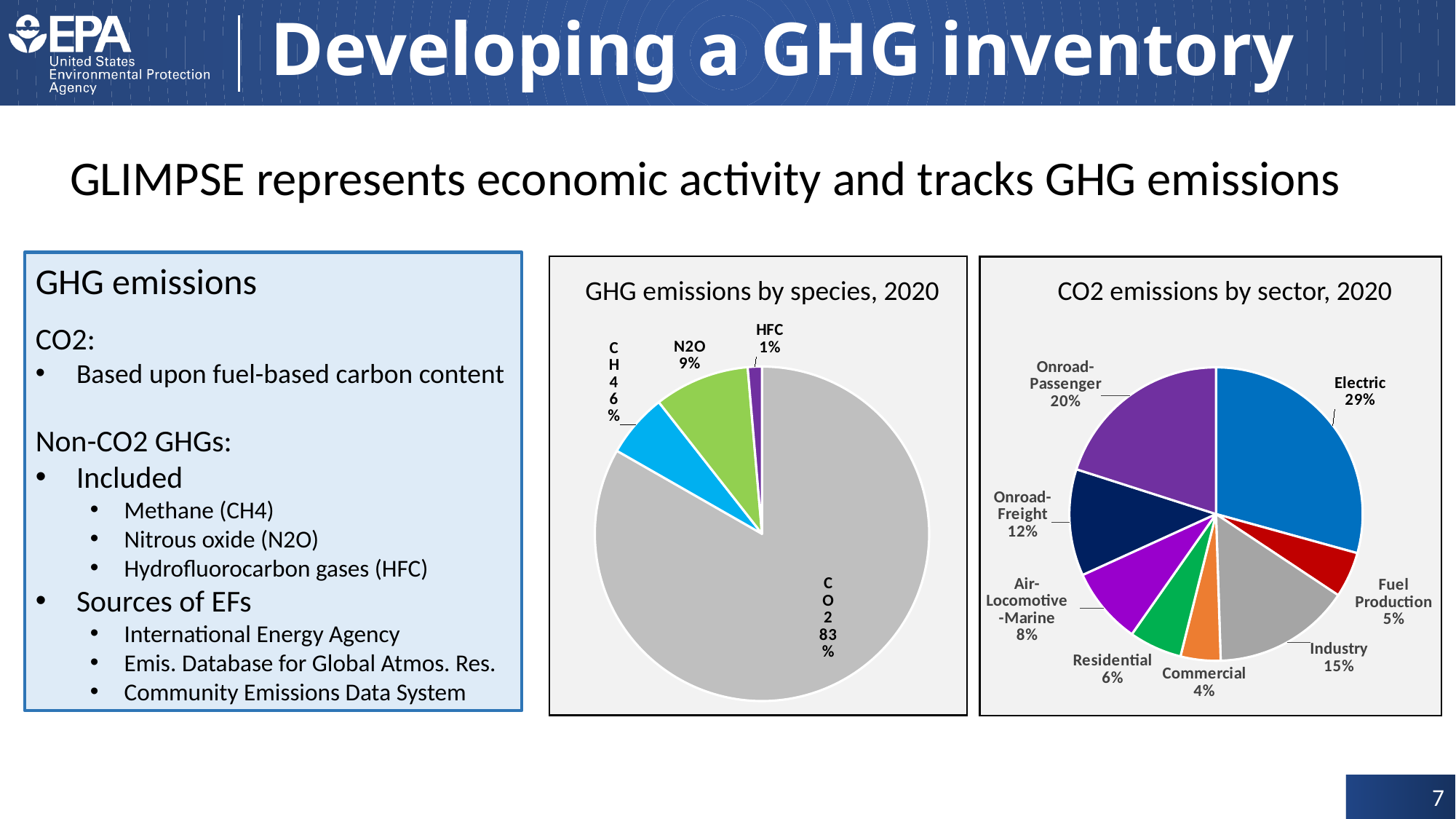
In the 'CO2 emissions by sector, 2020' chart, what share of emissions comes from Industry? 15% What kind of chart is 'CO2 emissions by sector, 2020'? Pie chart In the 'CO2 emissions by sector, 2020' chart, which sector has the largest share? Electric In the 'CO2 emissions by sector, 2020' chart, which is larger, Onroad-Passenger or Onroad-Freight? Onroad-Passenger In the 'CO2 emissions by sector, 2020' chart, what colour is the Electric slice? Blue In the 'GHG emissions by species, 2020' chart, which species has the smallest share? HFC In the 'GHG emissions by species, 2020' chart, how many species slices are shown? 4 In the 'GHG emissions by species, 2020' chart, what share of emissions is CO2? 83% In the 'CO2 emissions by sector, 2020' chart, what is the difference in percentage points between Electric and Fuel Production? 24 In the 'GHG emissions by species, 2020' chart, what is the difference in percentage points between N2O and CH4? 3 In the 'GHG emissions by species, 2020' chart, what share of emissions is CH4? 6% In the 'CO2 emissions by sector, 2020' chart, how many sectors are shown? 8